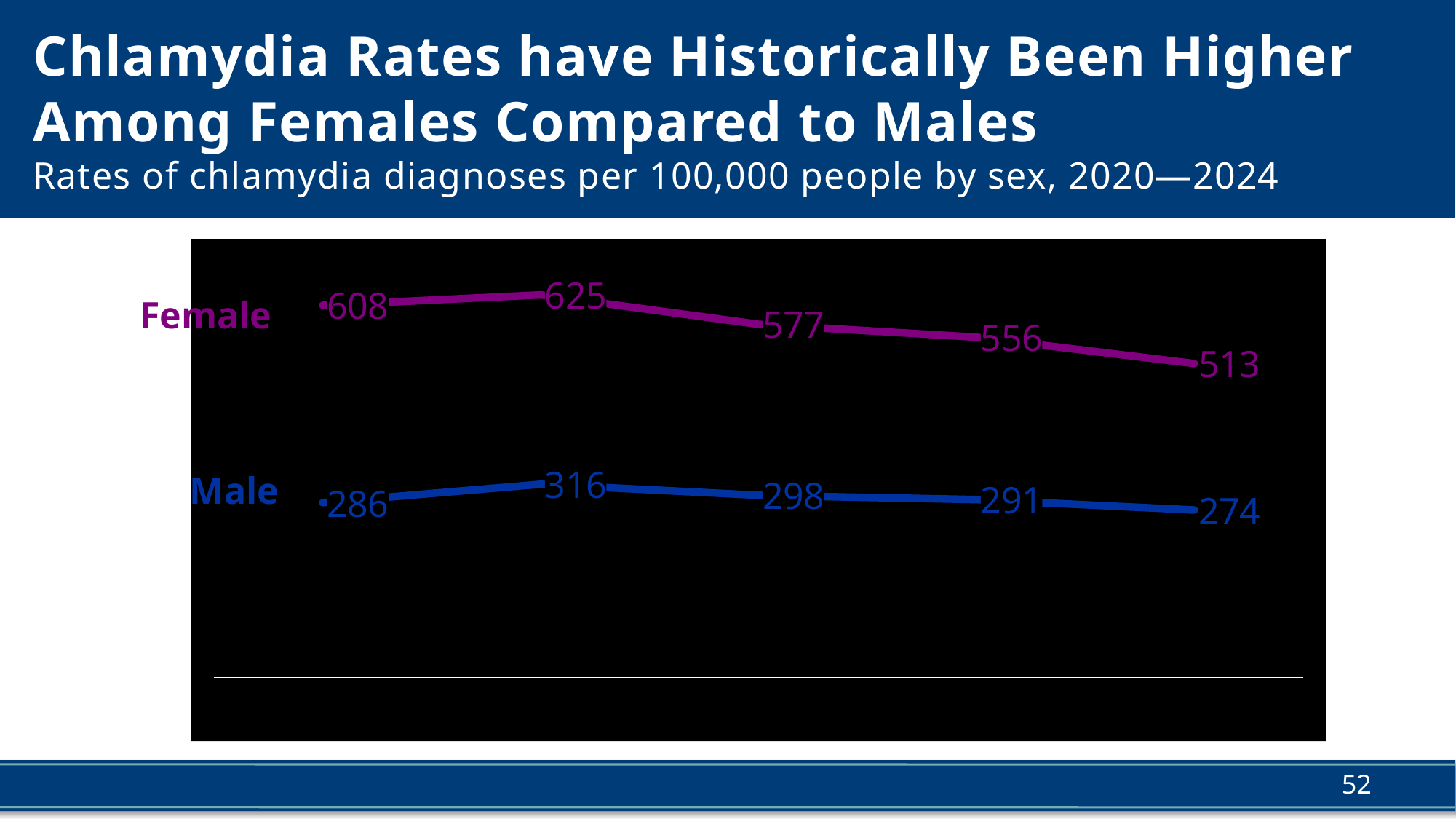
What is the difference between the first and last values on the Female line (608 and 513)? 95 Which series has the higher values across all points, Female or Male? Female What is the value of the first (leftmost) point on the Female line? 608 What kind of chart is shown on the slide? line chart What colour is the Female line? purple After its second point, does the Male line rise or fall toward the right? fall What is the highest value shown on the Female line? 625 How many data points are plotted on each line? 5 What is the lowest value shown on the Male line? 274 What is the value of the last (rightmost) point on the Male line? 274 How many series are plotted on the chart? 2 At the last point, how much higher is the Female value (513) than the Male value (274)? 239